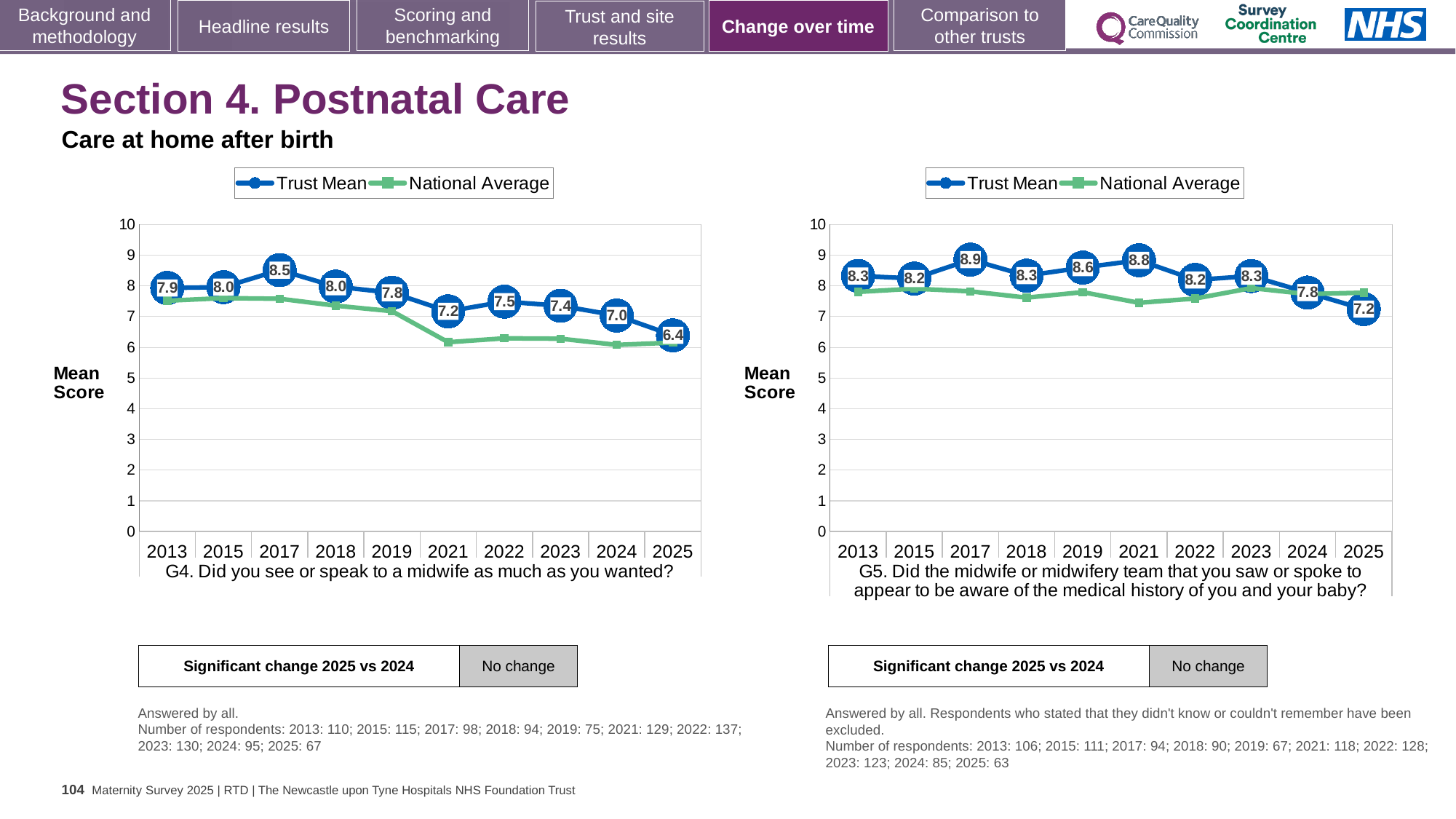
In the G5 chart on the right, is the Trust Mean higher in 2019 or in 2022? 2019 In the G5 chart on the right, what is the Trust Mean for 2021? 8.8 In the G4 chart on the left, which year has the lowest Trust Mean? 2025 In the G4 chart on the left, is the National Average for 2025 greater or less than 7? less How many series does the legend of the G5 chart on the right list? 2 What kind of chart is the G4 chart on the left? Line chart In the G4 chart on the left, what is the difference between the Trust Mean in 2017 and in 2025? 2.1 In the G5 chart on the right, what is the difference between the Trust Mean in 2024 and in 2025? 0.6 In the G4 chart on the left, what is the Trust Mean for 2017? 8.5 In the G4 chart on the left, what is the Trust Mean for 2025? 6.4 In the G5 chart on the right, which year has the highest Trust Mean? 2017 How many years are plotted on the x axis of the G4 chart on the left? 10